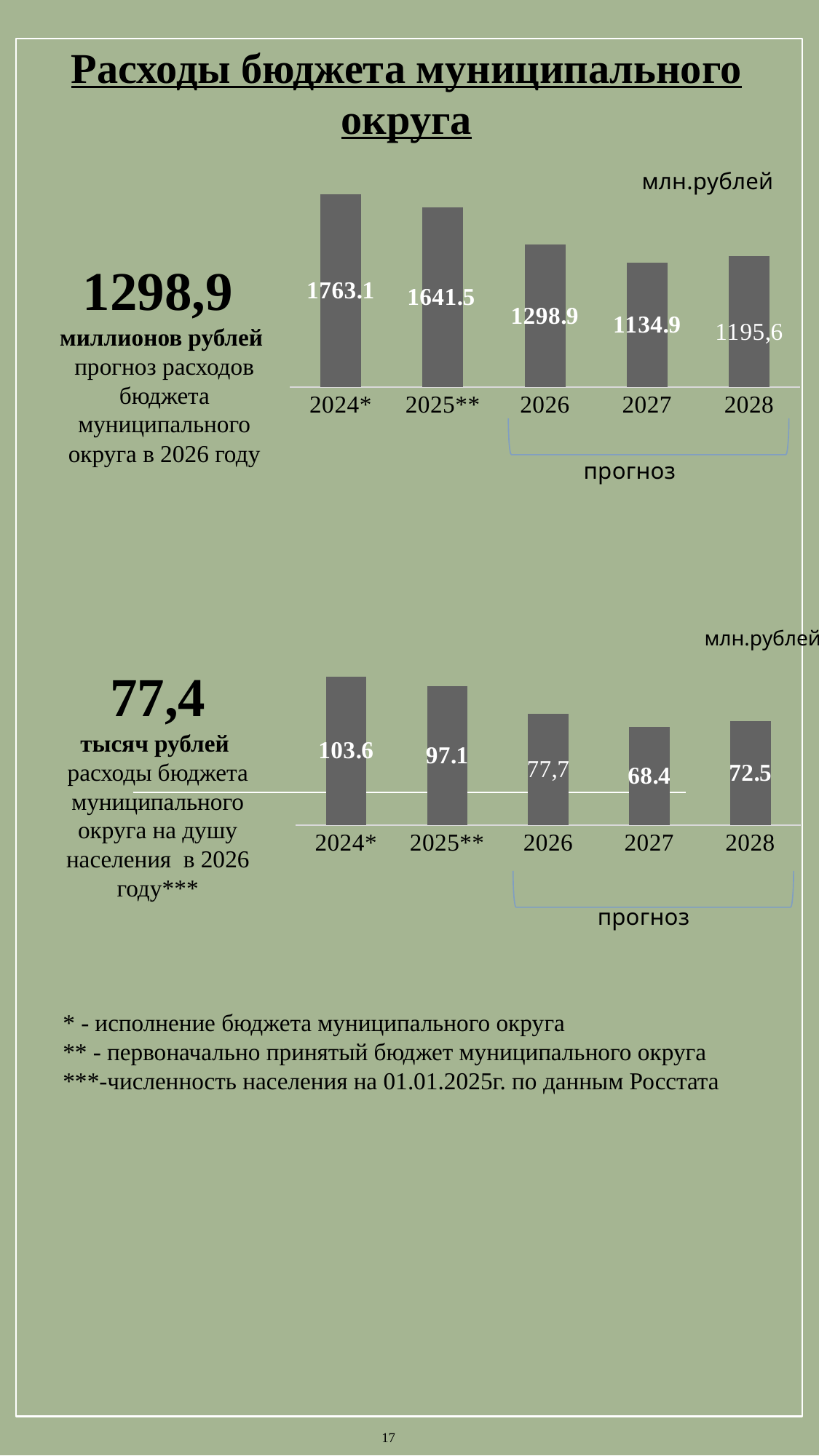
In the bottom chart (per capita expenditures), which is larger, the value for 2027 or the value for 2028? 2028 In the top chart (budget expenditures, млн.рублей), which year has the lowest value? 2027 In the top chart (budget expenditures, млн.рублей), what is the value for 2028? 1195,6 In the bottom chart (per capita expenditures), what is the value for 2026? 77,7 In the top chart (budget expenditures, млн.рублей), what is the difference between the values for 2024* and 2025**? 121.6 In the top chart (budget expenditures, млн.рублей), how many years are shown? 5 In the top chart (budget expenditures, млн.рублей), which year has the highest value? 2024* In the top chart (budget expenditures, млн.рублей), what is the value for 2024*? 1763.1 In the top chart (budget expenditures, млн.рублей), do the values rise or fall from 2024* to 2027? fall What type of chart is the bottom chart (per capita expenditures)? bar chart In the bottom chart (per capita expenditures), what is the value for 2027? 68.4 In the bottom chart (per capita expenditures), what is the difference between the values for 2024* and 2025**? 6.5